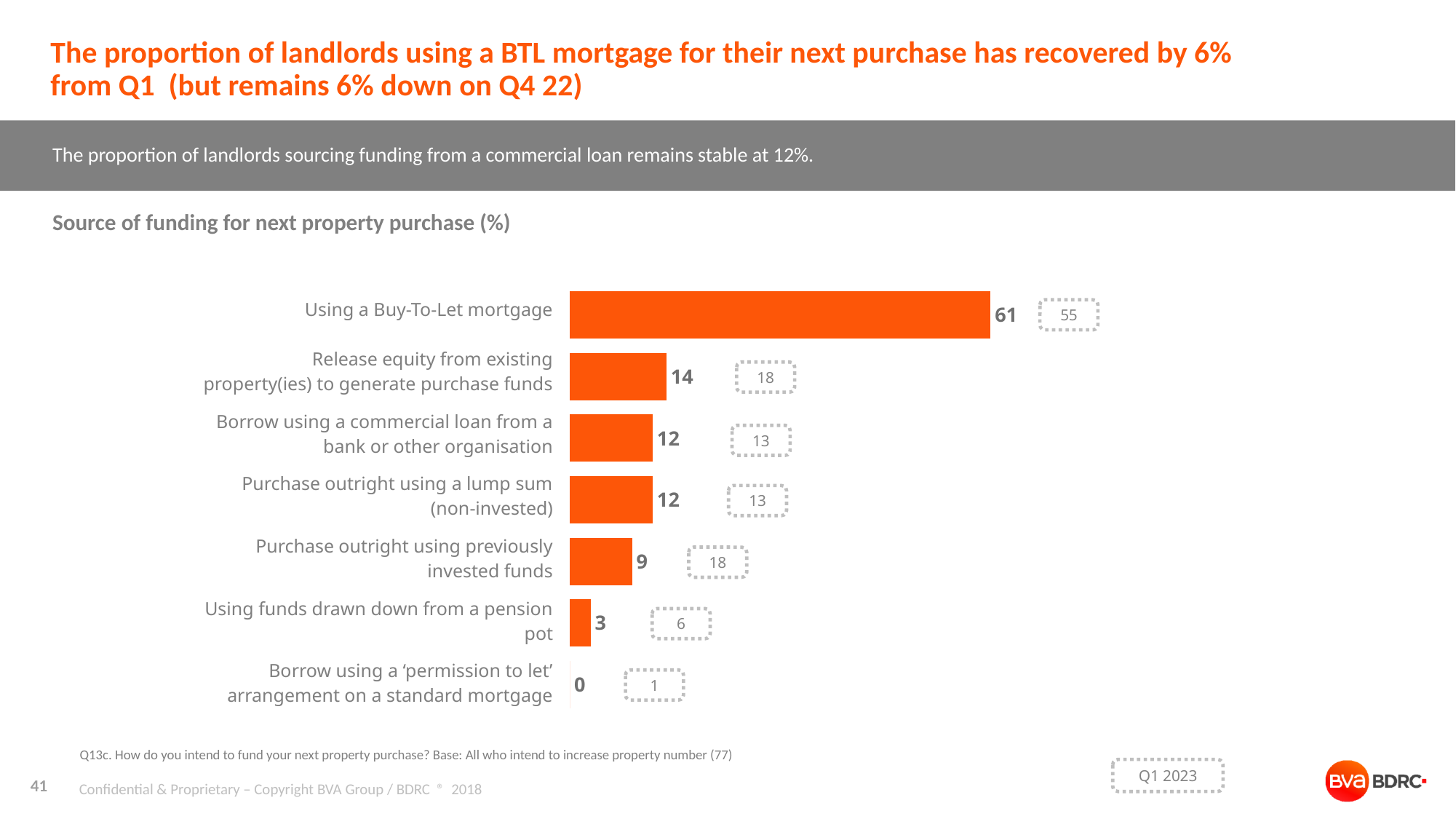
Which source of funding has the highest value in the chart? Using a Buy-To-Let mortgage What is the title of the chart? Source of funding for next property purchase (%) What is the value for 'Release equity from existing property(ies) to generate purchase funds'? 14 What is the difference between the value for 'Using a Buy-To-Let mortgage' and 'Release equity from existing property(ies) to generate purchase funds'? 47 What is the value for 'Using funds drawn down from a pension pot'? 3 What is the value for 'Purchase outright using previously invested funds'? 9 How many funding source categories are shown in the chart? 7 Which is larger: the value for 'Purchase outright using previously invested funds' or 'Using funds drawn down from a pension pot'? Purchase outright using previously invested funds What is the Q1 2023 value shown in the dashed box next to 'Using a Buy-To-Let mortgage'? 55 What kind of chart is shown on the slide? Bar chart Which source of funding has the lowest value in the chart? Borrow using a 'permission to let' arrangement on a standard mortgage What is the value for 'Using a Buy-To-Let mortgage' in the chart? 61